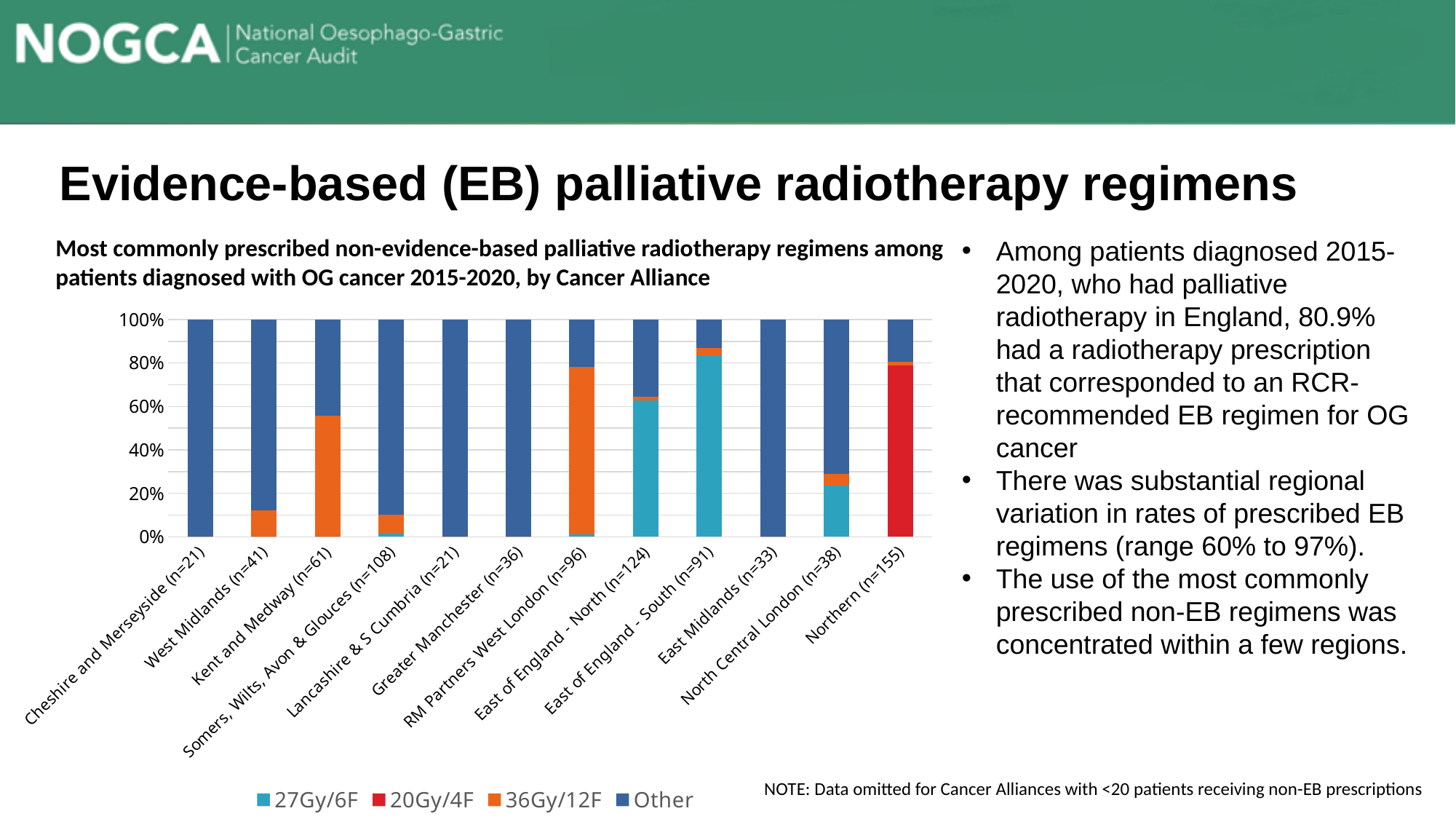
Which is the only Cancer Alliance with a 20Gy/4F segment in the chart? Northern (n=155) Is the 20Gy/4F share for Northern (n=155) greater or less than 60%? greater Is the 36Gy/12F share for Kent and Medway (n=61) greater or less than 40%? greater Is the 27Gy/6F share for North Central London (n=38) greater or less than 40%? less Which Cancer Alliance has the largest 27Gy/6F share? East of England - South (n=91) Which Cancer Alliance has the largest 36Gy/12F share? RM Partners West London (n=96) How many series does the chart legend list? 4 How many Cancer Alliances are shown on the x axis of the chart? 12 Which colour represents the 'Other' series in the chart legend? Dark blue What type of chart is shown on the slide? Stacked bar chart